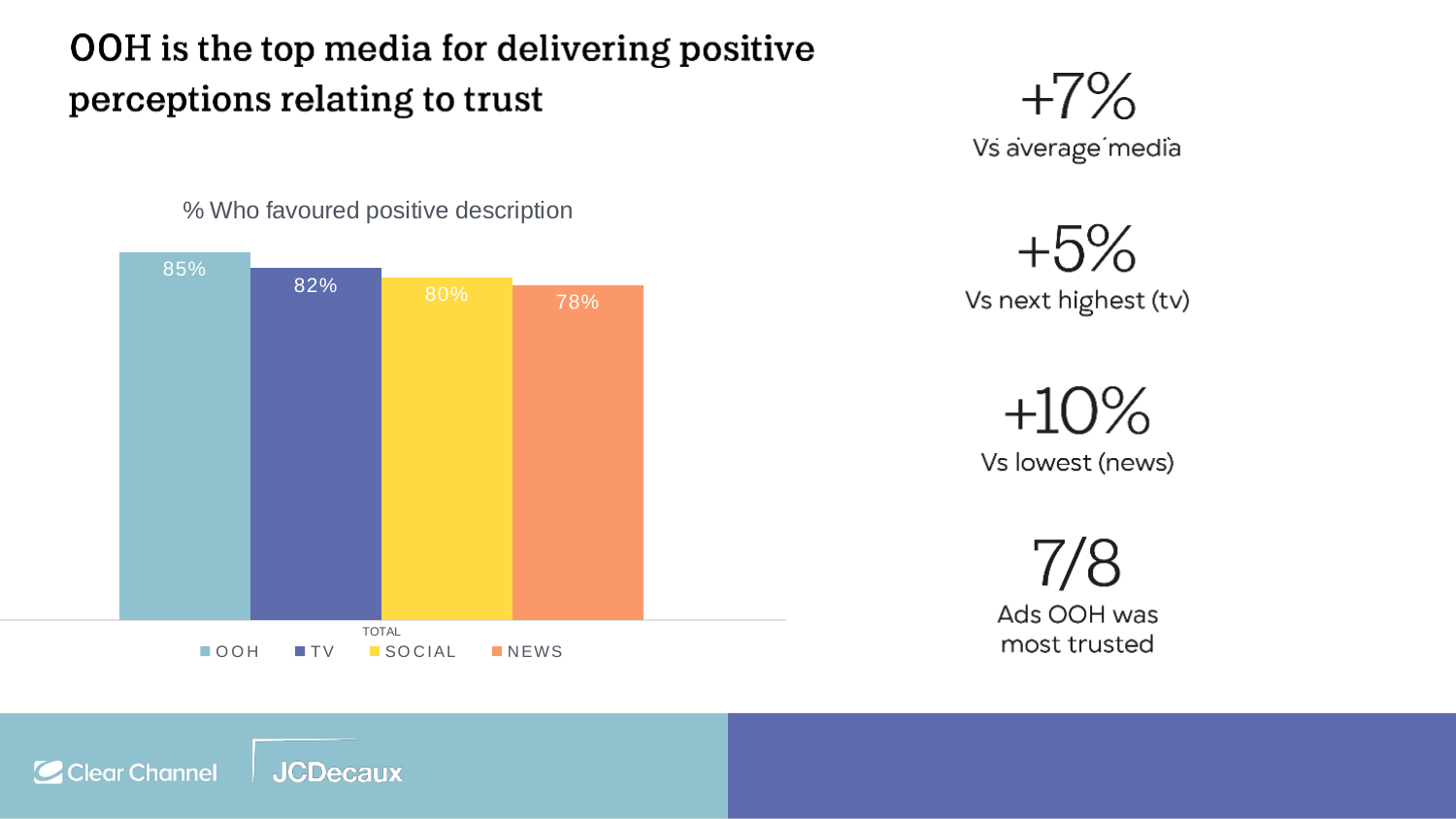
Which media has the lowest percentage who favoured a positive description? News What is the title of the chart? % Who favoured positive description What is the difference in percentage points between OOH and News? 7 What is the value shown for News in the chart? 78% What percentage of respondents favoured a positive description for OOH? 85% Which media has the highest percentage who favoured a positive description? OOH What is the value shown for TV in the chart? 82% How many media categories are shown in the chart? 4 What type of chart is shown on the slide? Bar chart Which has a higher value, TV or Social? TV What is the difference in percentage points between OOH and TV? 3 What is the value shown for Social in the chart? 80%